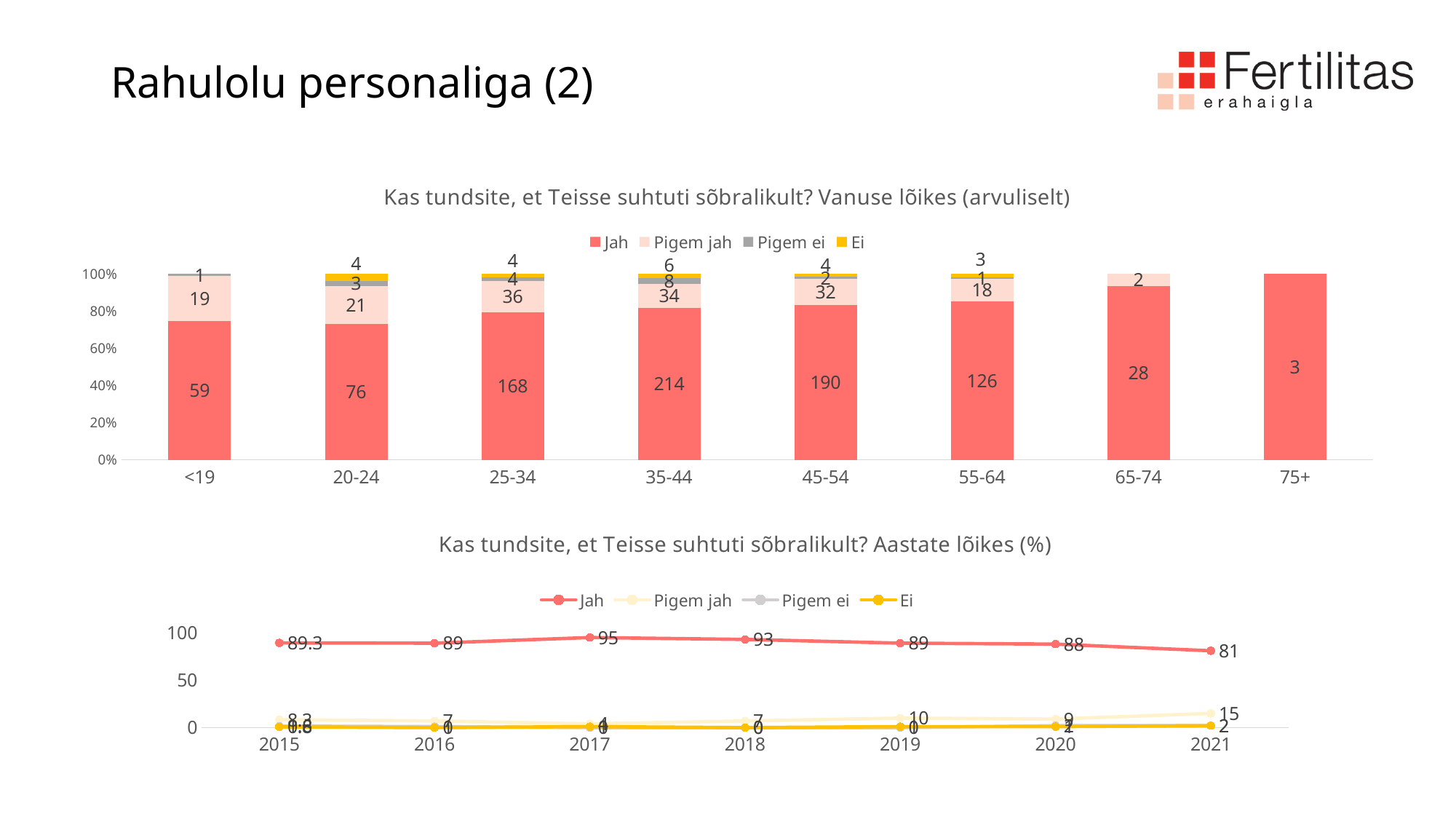
In the bottom chart (Aastate lõikes), which year has the lowest Jah value? 2021 In the top chart (Vanuse lõikes), how many series does the legend list? 4 What kind of chart is the top chart (Vanuse lõikes)? Stacked bar chart In the top chart (Vanuse lõikes), what is the Jah value for the 35-44 age group? 214 In the bottom chart (Aastate lõikes), what is the Pigem jah value for 2021? 15 In the top chart (Vanuse lõikes), what is the total of the stacked bar for the 20-24 age group? 104 In the top chart (Vanuse lõikes), how many age groups are shown on the x axis? 8 In the bottom chart (Aastate lõikes), does the Jah line rise or fall from 2017 to 2021? Fall In the bottom chart (Aastate lõikes), which is larger: the Jah value for 2018 or for 2020? 2018 In the top chart (Vanuse lõikes), what is the difference between the Jah values for 35-44 and 45-54? 24 In the top chart (Vanuse lõikes), which age group has the highest Jah value? 35-44 In the bottom chart (Aastate lõikes), what is the Jah value for 2017? 95